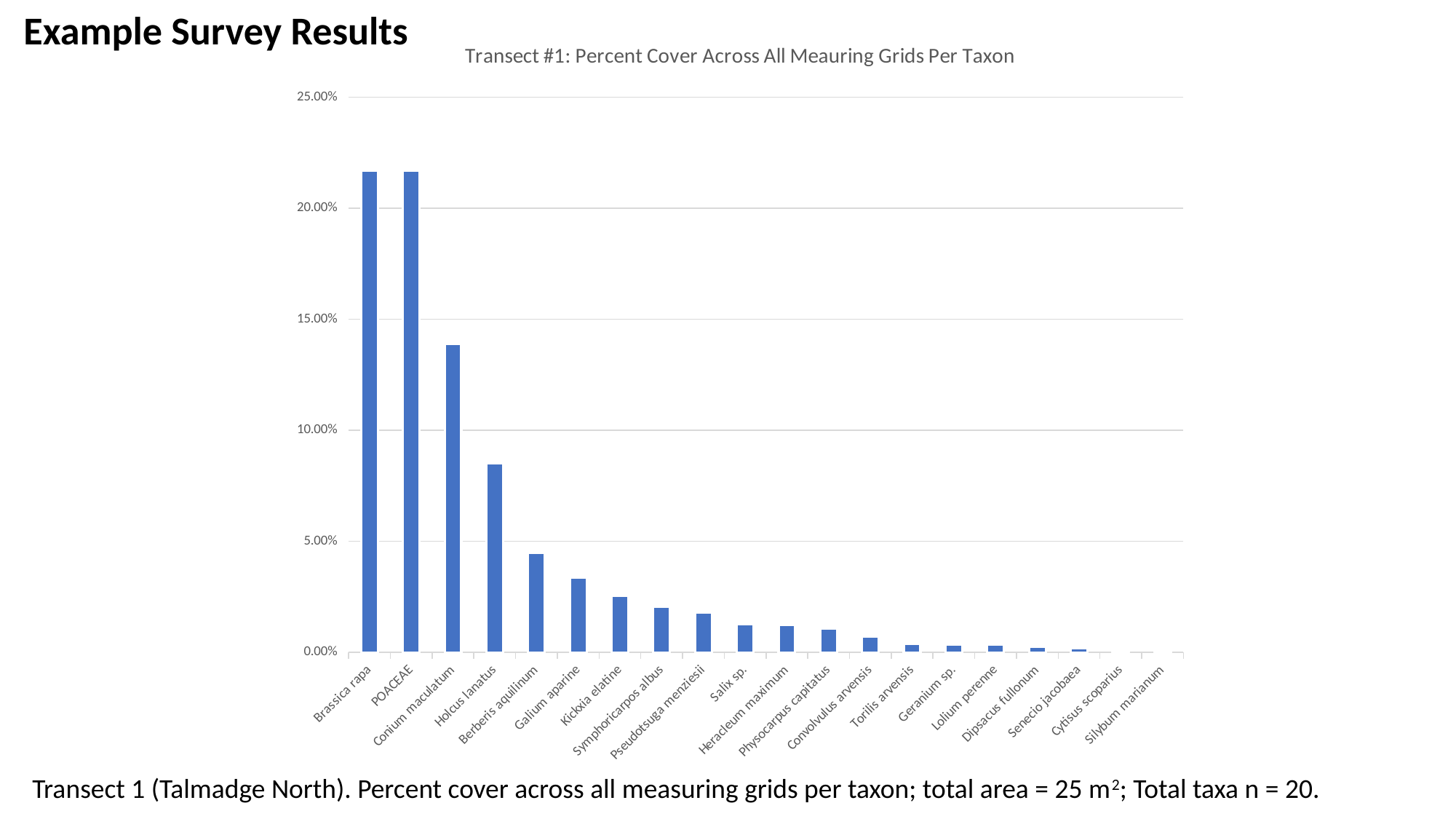
Is the value for POACEAE greater or less than 25.00%? less What is the title of the chart? Transect #1: Percent Cover Across All Meauring Grids Per Taxon Do the bar values rise or fall moving from left to right along the x axis? fall What kind of chart is shown on the slide? bar chart How many taxa (categories) are plotted on the x axis of the chart? 20 Which has the larger value, Galium aparine or Salix sp.? Galium aparine Is the value for Brassica rapa greater or less than 20.00%? greater Is the value for Conium maculatum greater or less than 15.00%? less Which has the larger value, Conium maculatum or Holcus lanatus? Conium maculatum What is the highest value shown on the y axis of the chart? 25.00%